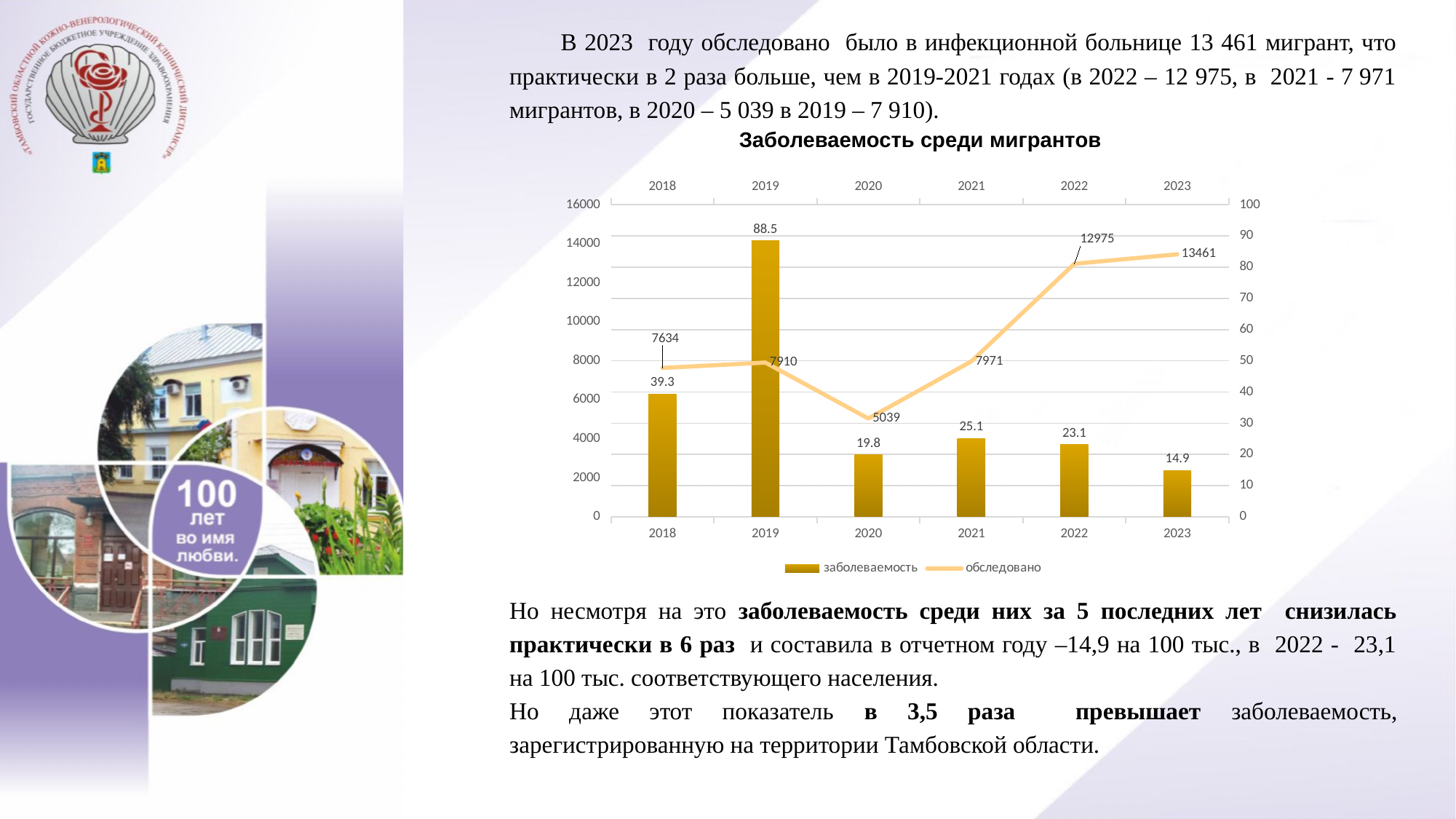
What is the value of обследовано for 2022? 12975 Which year has the highest заболеваемость value? 2019 How many series does the legend list? 2 What is the difference between the заболеваемость values for 2022 and 2023? 8.2 What is the value of заболеваемость for 2019? 88.5 What is the title of the chart? Заболеваемость среди мигрантов How many years are shown on the x axis? 6 What is the difference between the обследовано values for 2023 and 2022? 486 Which is larger, the заболеваемость value for 2021 or for 2022? 2021 What is the value of заболеваемость for 2023? 14.9 Which year has the lowest обследовано value? 2020 What is the value of обследовано for 2020? 5039